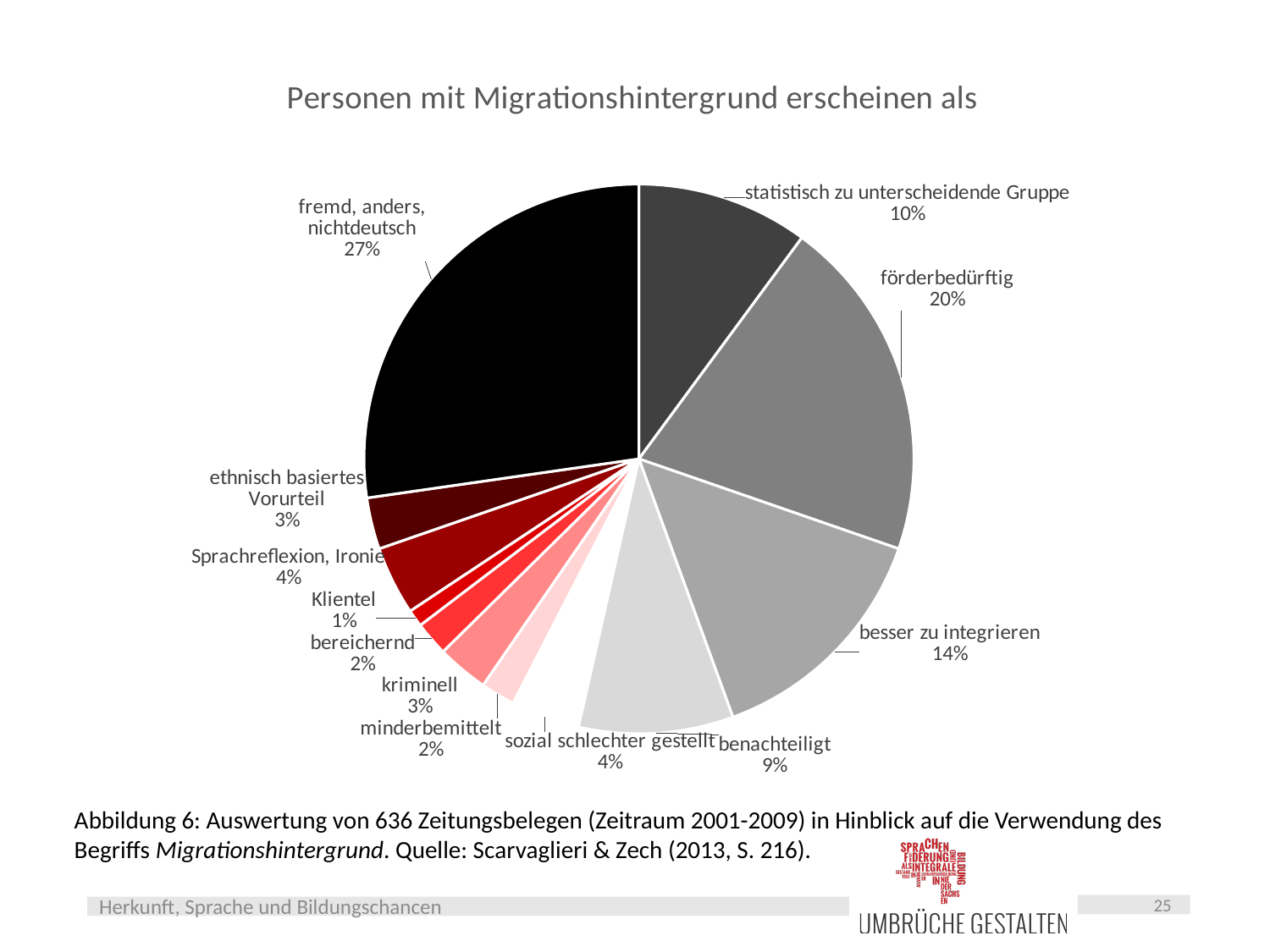
What percentage is shown for "Sprachreflexion, Ironie"? 4% What percentage is shown for "benachteiligt"? 9% Which is larger, the slice for "kriminell" or the slice for "bereichernd"? kriminell Which category has the smallest slice of the pie? Klientel What kind of chart is shown on the slide? pie chart What percentage is shown for "statistisch zu unterscheidende Gruppe"? 10% How many categories (slices) does the pie chart have? 12 What is the title of the chart? Personen mit Migrationshintergrund erscheinen als What share of the pie does "besser zu integrieren" have? 14% What share of the pie does "förderbedürftig" have? 20% What is the difference in percentage points between "fremd, anders, nichtdeutsch" and "förderbedürftig"? 7 Which category has the largest slice of the pie? fremd, anders, nichtdeutsch